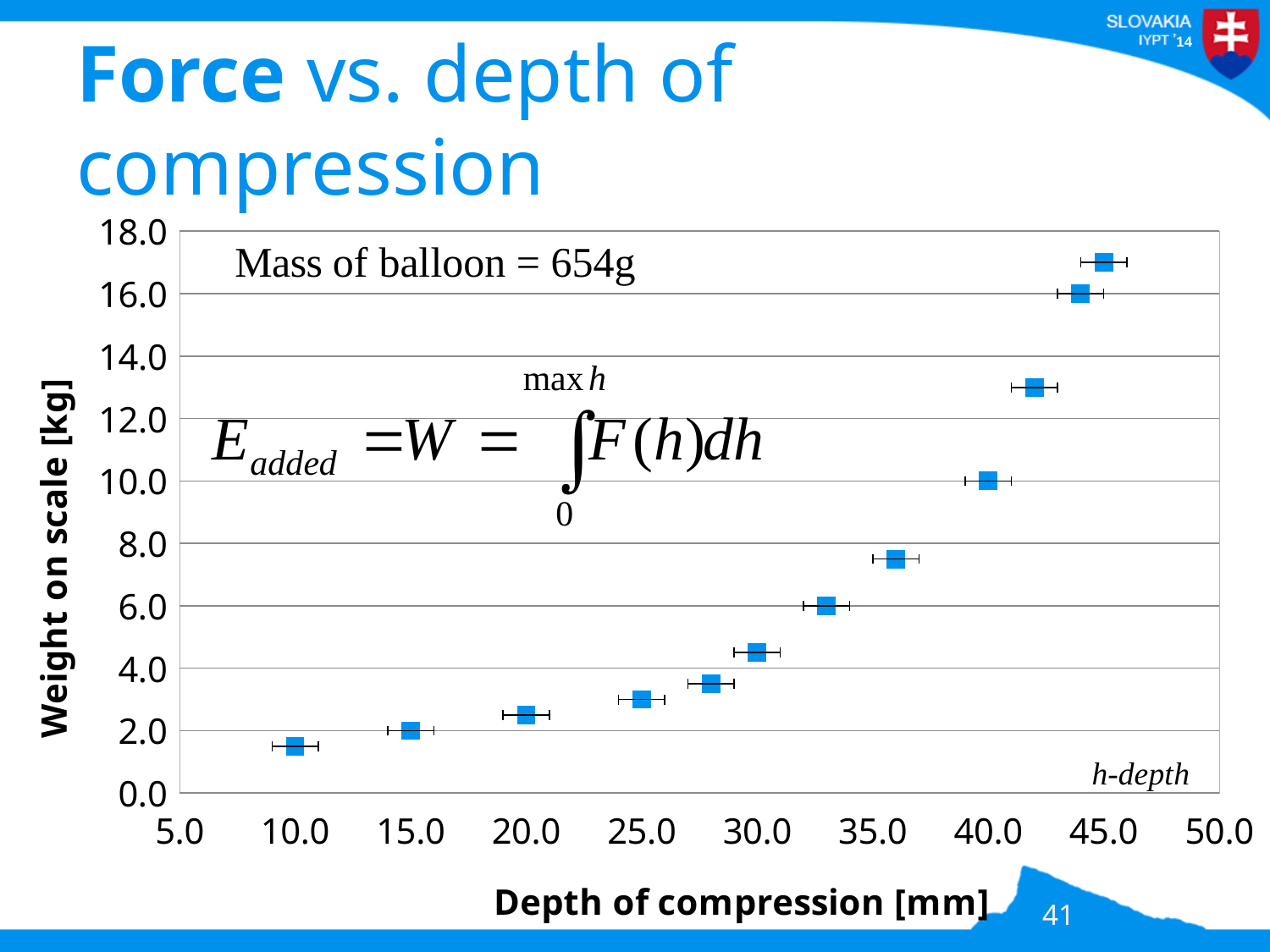
What mass of balloon is stated on the chart? 654g What kind of chart is shown on the slide? Scatter chart Is the weight on scale at a depth of about 42 mm greater or less than 12.0 kg? greater What is the title of the vertical axis? Weight on scale [kg] At which depth of compression is the weight on scale highest? 45.0 mm Do the weight values rise or fall as the depth of compression increases? Rise Is the weight on scale at the highest point greater or less than 16.0 kg? greater Is the weight on scale at a depth of about 36 mm greater or less than 6.0 kg? greater At which depth of compression is the weight on scale lowest? 10.0 mm Which has the larger weight on scale: the point at 30.0 mm or the point at 40.0 mm? 40.0 mm How many data points are plotted on the chart? 12